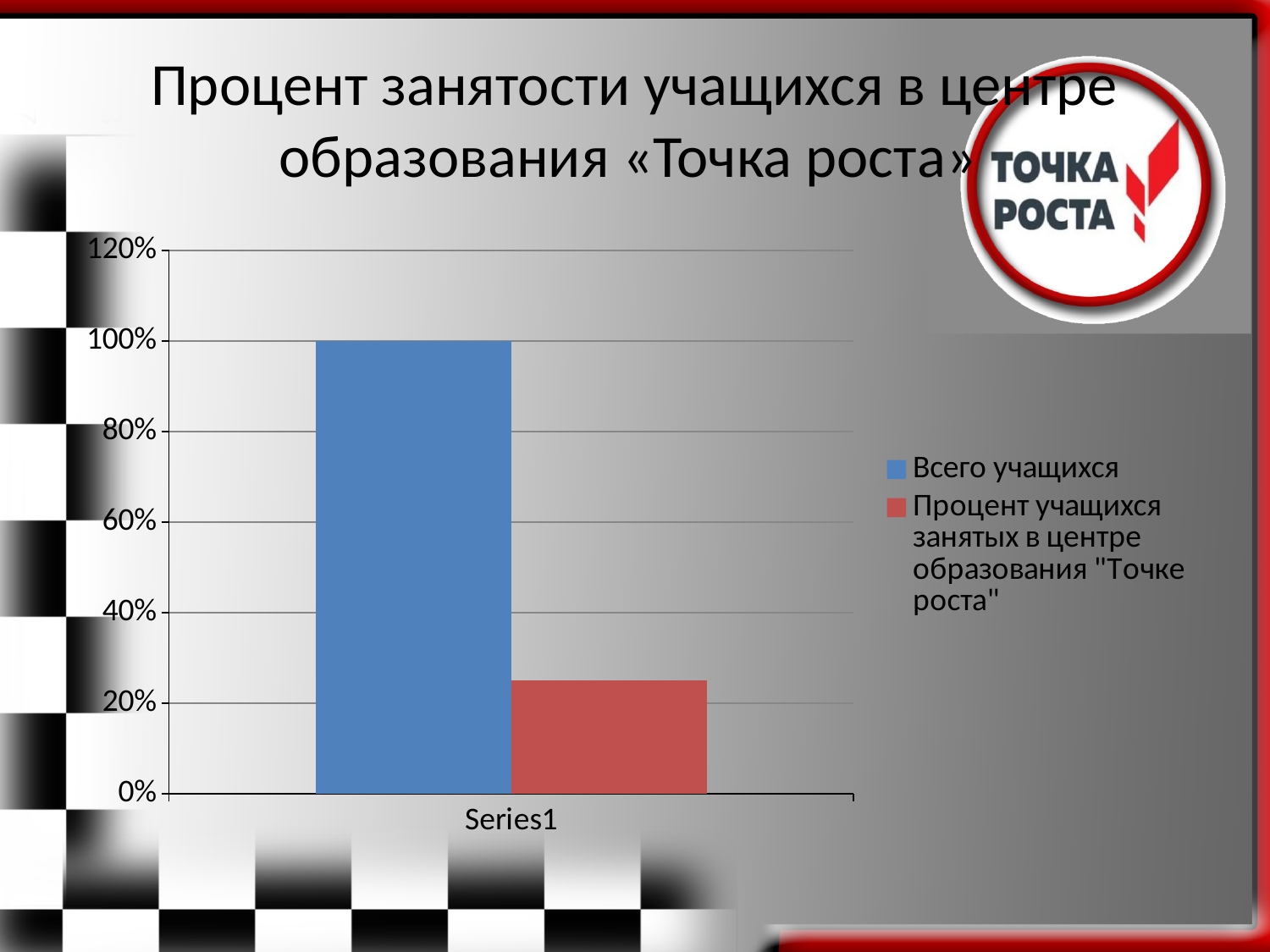
What is the highest value shown on the vertical axis of the chart? 120% What is the title of the slide containing the chart? Процент занятости учащихся в центре образования «Точка роста» Is the value for "Процент учащихся занятых в центре образования "Точке роста"" greater or less than 20%? greater Which bar is taller: "Всего учащихся" or "Процент учащихся занятых в центре образования "Точке роста""? Всего учащихся Is the value for "Процент учащихся занятых в центре образования "Точке роста"" greater or less than 40%? less Which series has the highest value in the chart? Всего учащихся What colour is the "Всего учащихся" bar? Blue Which series has the lowest value in the chart? Процент учащихся занятых в центре образования "Точке роста" How many series does the legend list? 2 What is the value of the "Всего учащихся" bar? 100% How many categories are shown on the x axis of the chart? 1 What kind of chart is shown on the slide? Bar chart